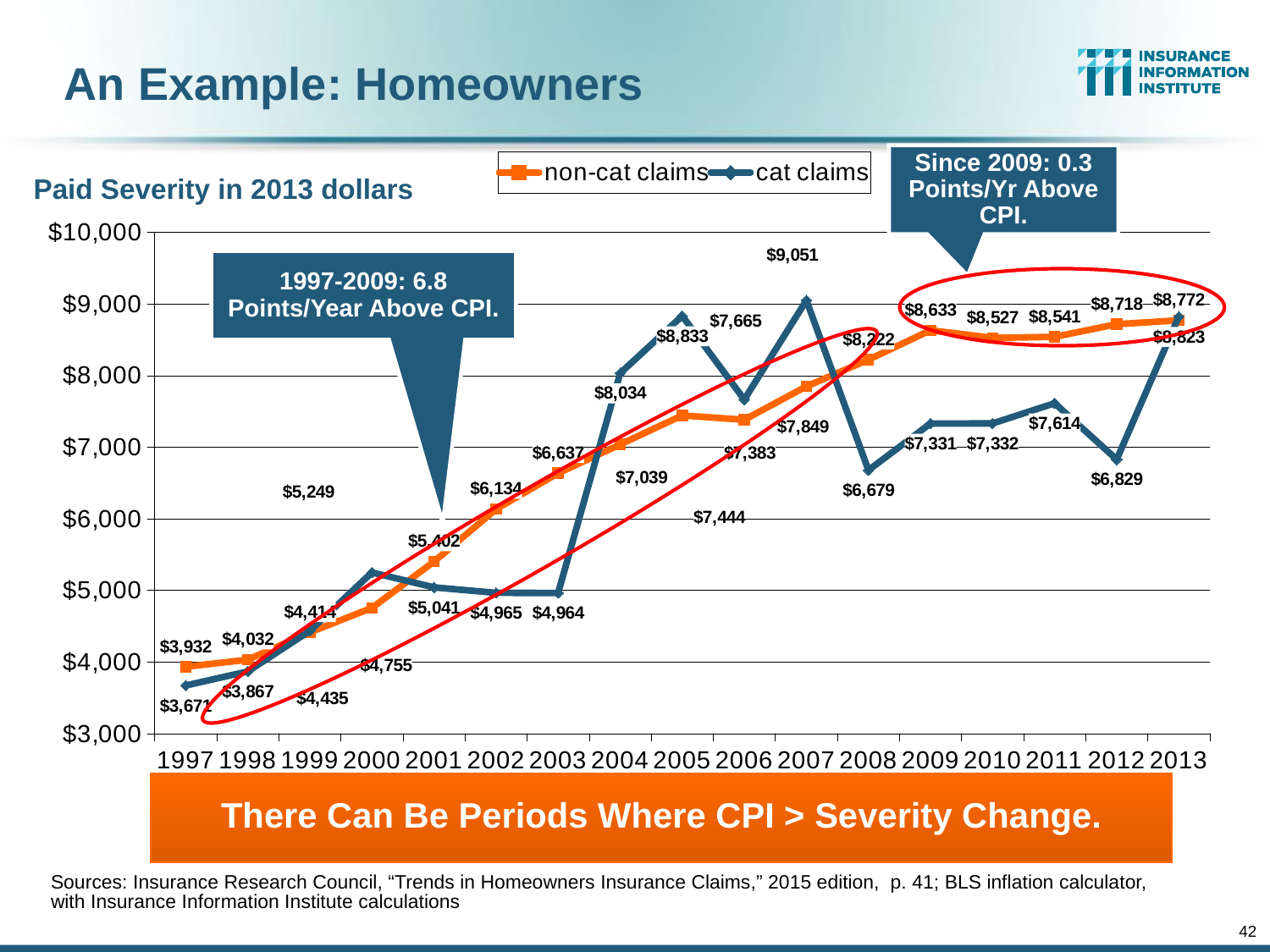
In which year are cat claims lowest? 1997 What is the value of cat claims in 2007? $9,051 How many years are plotted along the x axis? 17 What is the value of non-cat claims in 2009? $8,633 In which year are cat claims highest? 2007 What is the difference between cat claims and non-cat claims in 2007? $1,202 How many series does the legend list? 2 What is the value of non-cat claims in 2012? $8,718 What is the value of cat claims in 2008? $6,679 What kind of chart is shown on the slide? line chart In 2008, which is larger: non-cat claims or cat claims? non-cat claims Is the value for cat claims in 2005 greater or less than $8,000? greater